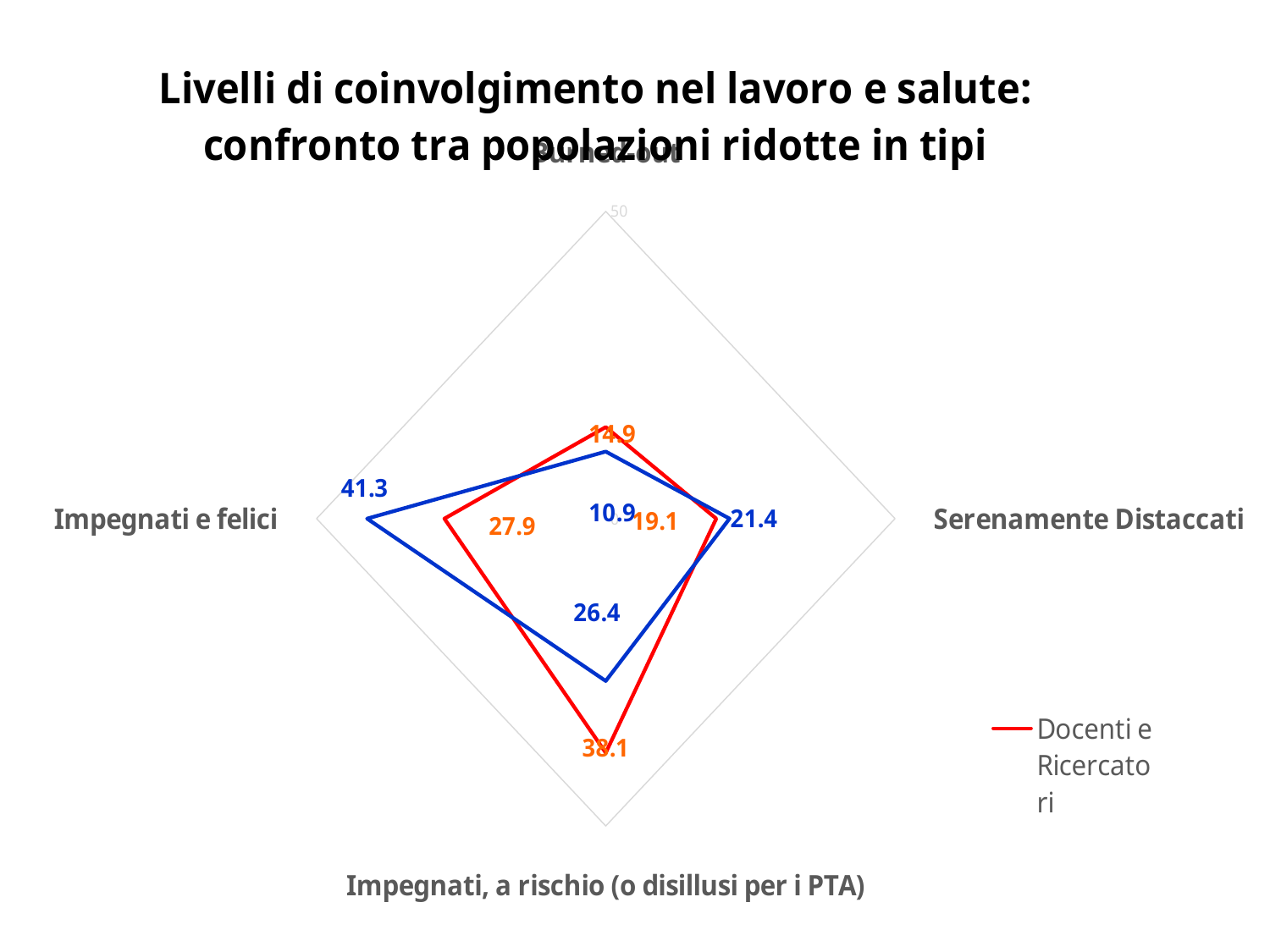
For which category does the red series (Docenti e Ricercatori) have its highest value? Impegnati, a rischio (o disillusi per i PTA) What is the difference between the blue series and the red series for 'Impegnati e felici'? 13.4 Which series has the larger value for 'Impegnati, a rischio (o disillusi per i PTA)', the red or the blue? red (Docenti e Ricercatori) What is the value of the red series (Docenti e Ricercatori) for 'Serenamente Distaccati'? 19.1 What is the value of the red series (Docenti e Ricercatori) for 'Impegnati, a rischio (o disillusi per i PTA)'? 38.1 What is the value of the blue series for 'Impegnati e felici'? 41.3 What is the value of the blue series for 'Serenamente Distaccati'? 21.4 How many categories (axes) does the radar chart have? 4 For which category does the blue series have its highest value? Impegnati e felici What kind of chart is shown on the slide? radar chart What is the value of the red series (Docenti e Ricercatori) for 'Impegnati e felici'? 27.9 What is the value of the blue series for 'Impegnati, a rischio (o disillusi per i PTA)'? 26.4